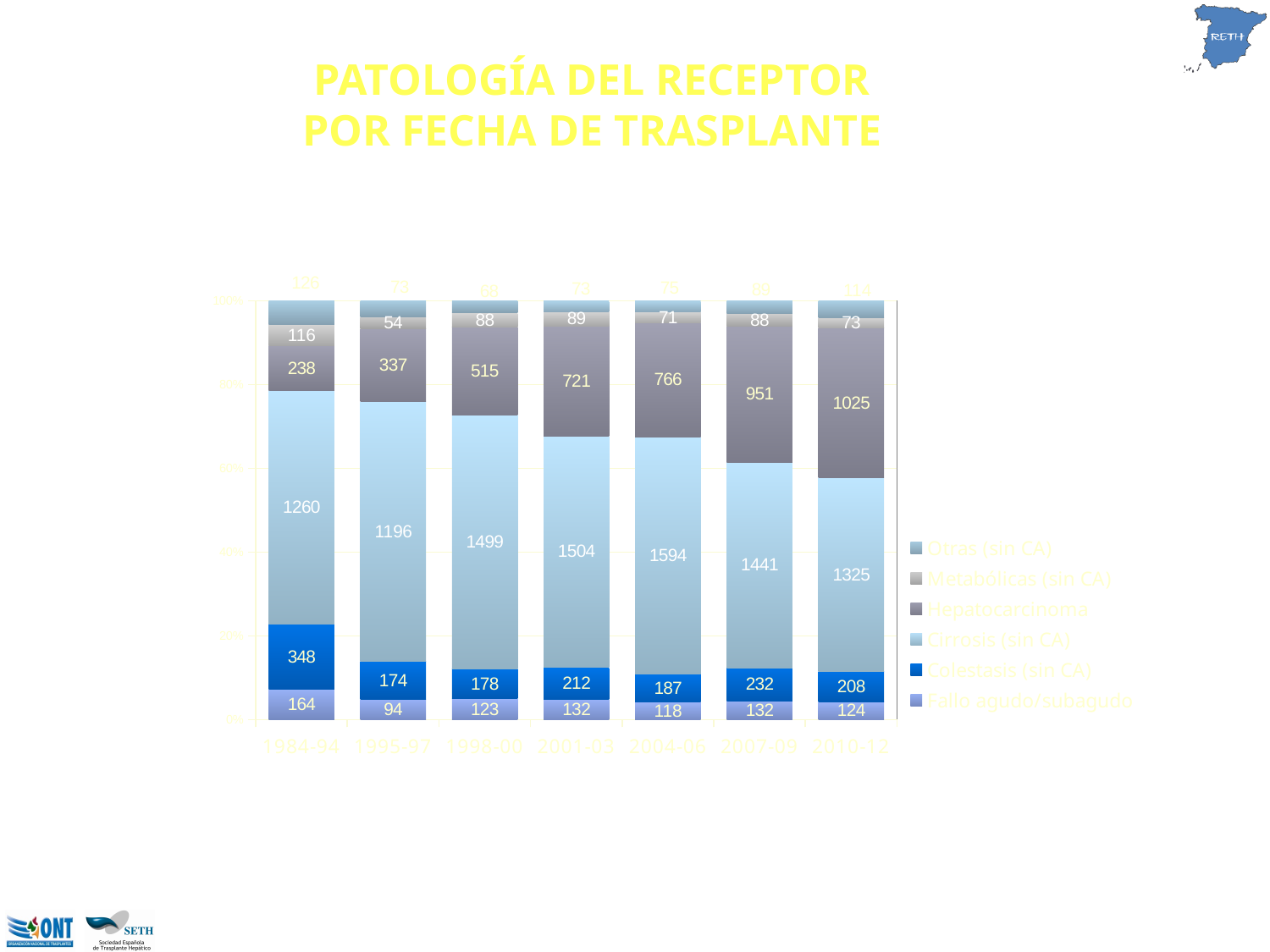
What is the value for Hepatocarcinoma in the 2010-12 period? 1025 What is the title of the chart on the slide? PATOLOGÍA DEL RECEPTOR POR FECHA DE TRASPLANTE How many series does the legend list? 6 How many time periods are shown on the x axis? 7 What is the value for Metabólicas (sin CA) in the 1995-97 period? 54 In which period is the Fallo agudo/subagudo value lowest? 1995-97 Do the Hepatocarcinoma values rise or fall from 1984-94 to 2010-12? Rise What is the difference between the Cirrosis (sin CA) values for 2004-06 and 1984-94? 334 In which period is the Hepatocarcinoma value highest? 2010-12 What is the value for Cirrosis (sin CA) in the 2004-06 period? 1594 What kind of chart is shown on the slide? Stacked bar chart Which period has the larger Colestasis (sin CA) value, 1984-94 or 2007-09? 1984-94